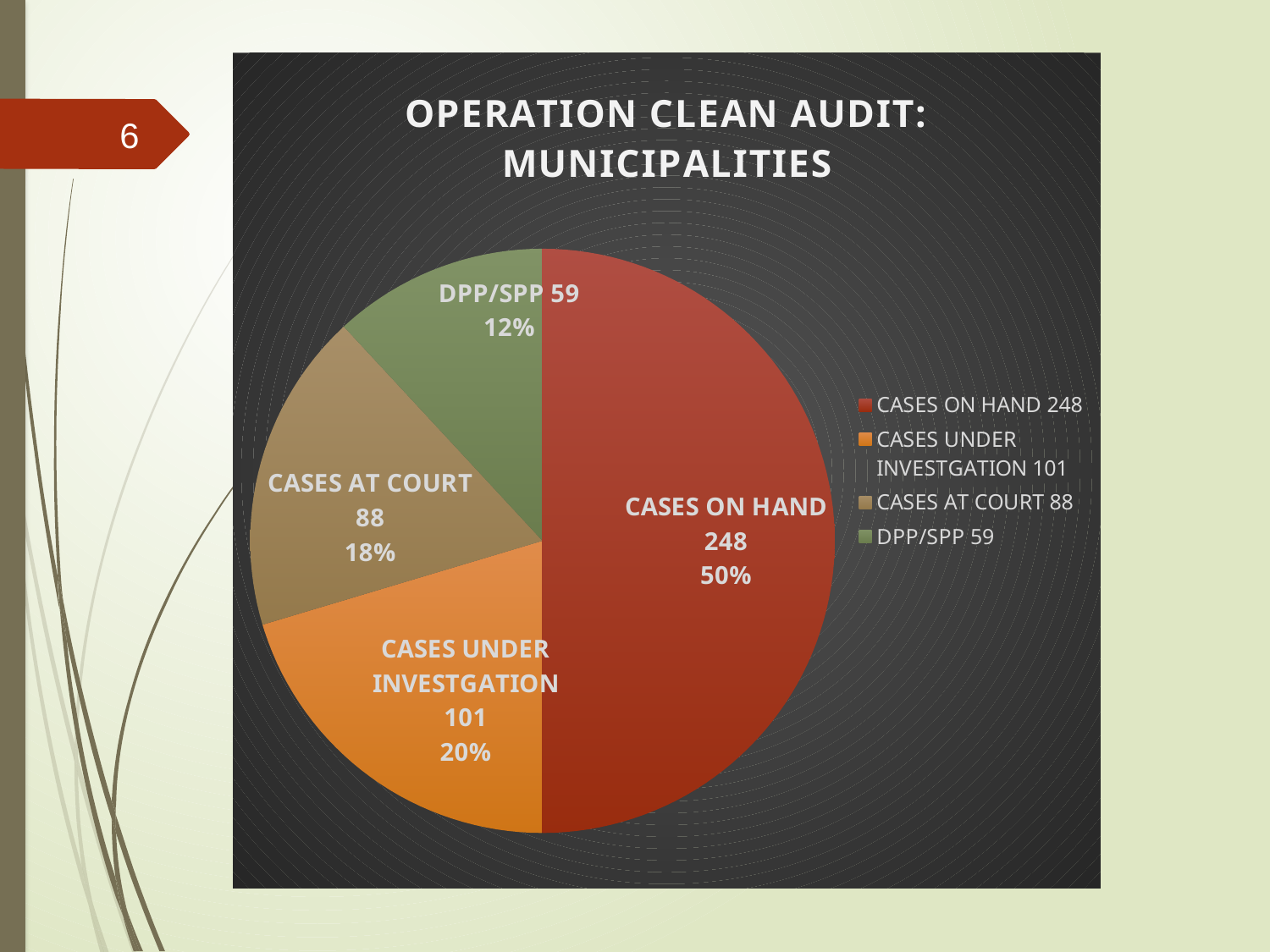
What percentage share of the pie does CASES ON HAND have? 50% Which category has the largest slice? CASES ON HAND What kind of chart is shown on the slide? pie chart What is the difference between the values for CASES ON HAND and CASES UNDER INVESTGATION? 147 What percentage share of the pie does DPP/SPP have? 12% What is the value for CASES AT COURT? 88 How many slices does the pie chart have? 4 What is the title of the chart? OPERATION CLEAN AUDIT: MUNICIPALITIES What is the value for CASES ON HAND? 248 Which category has the smallest slice? DPP/SPP What is the value for CASES UNDER INVESTGATION? 101 How many entries does the legend list? 4